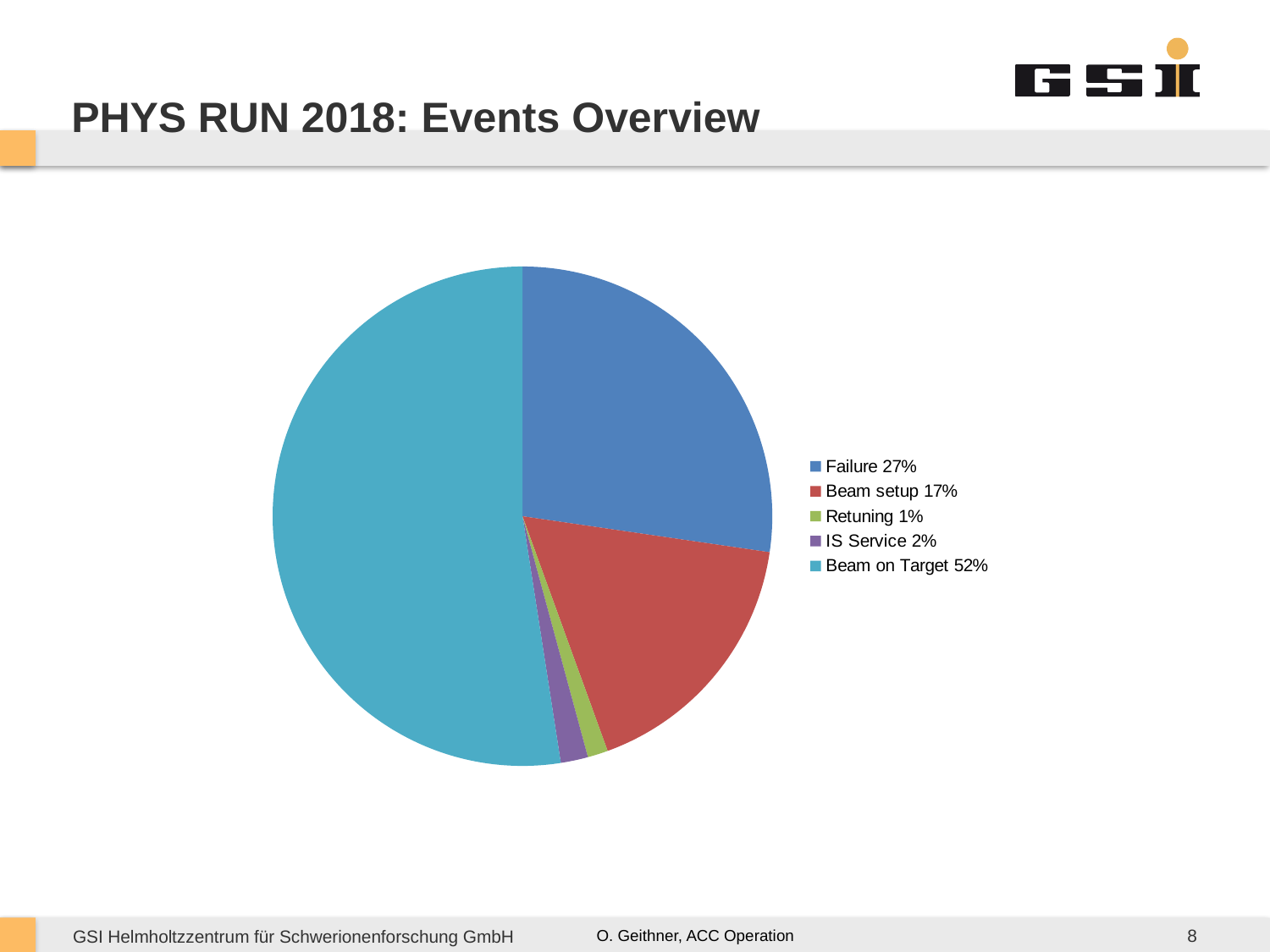
What share of the pie does IS Service account for? 2% What share of the pie does Failure account for? 27% What is the difference in percentage points between Beam on Target and Failure? 25% What kind of chart is shown on the slide? pie chart What share of the pie does Beam on Target account for? 52% How many categories does the pie chart show? 5 Which category has the smallest slice of the pie? Retuning Which category has the largest slice of the pie? Beam on Target Which is larger, the share for Failure or the share for Beam setup? Failure What colour is the Beam on Target slice in the pie chart? teal/light blue